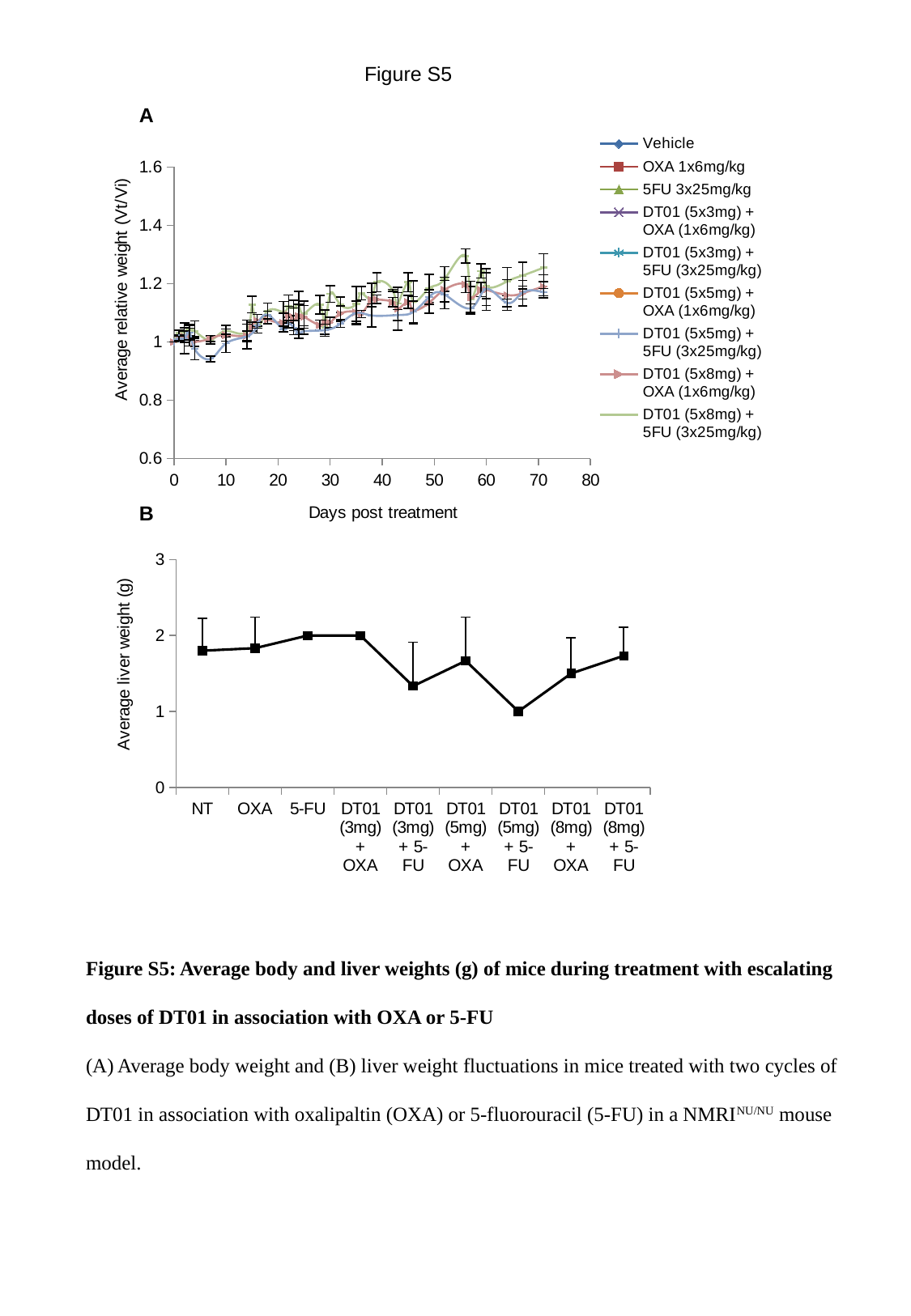
What kind of chart is chart B (Average liver weight)? line chart How many treatment groups are plotted along the x axis of chart B? 9 What is the y-axis label of chart B? Average liver weight (g) In chart A, is the value for the Vehicle series at day 0 greater or less than 0.8? greater In chart B, is the average liver weight for NT greater or less than 1? greater In chart B, is the average liver weight for DT01 (3mg) + 5-FU greater or less than 2? less What is the x-axis label of chart A? Days post treatment In chart B, which treatment group has the lowest average liver weight? DT01 (5mg) + 5-FU In chart B, which has the larger average liver weight, 5-FU or DT01 (3mg) + 5-FU? 5-FU How many series does the legend of chart A list? 9 In chart A, do the average relative weight values generally rise or fall as days post treatment increase? rise In chart B, which has the larger average liver weight, DT01 (8mg) + OXA or DT01 (5mg) + 5-FU? DT01 (8mg) + OXA